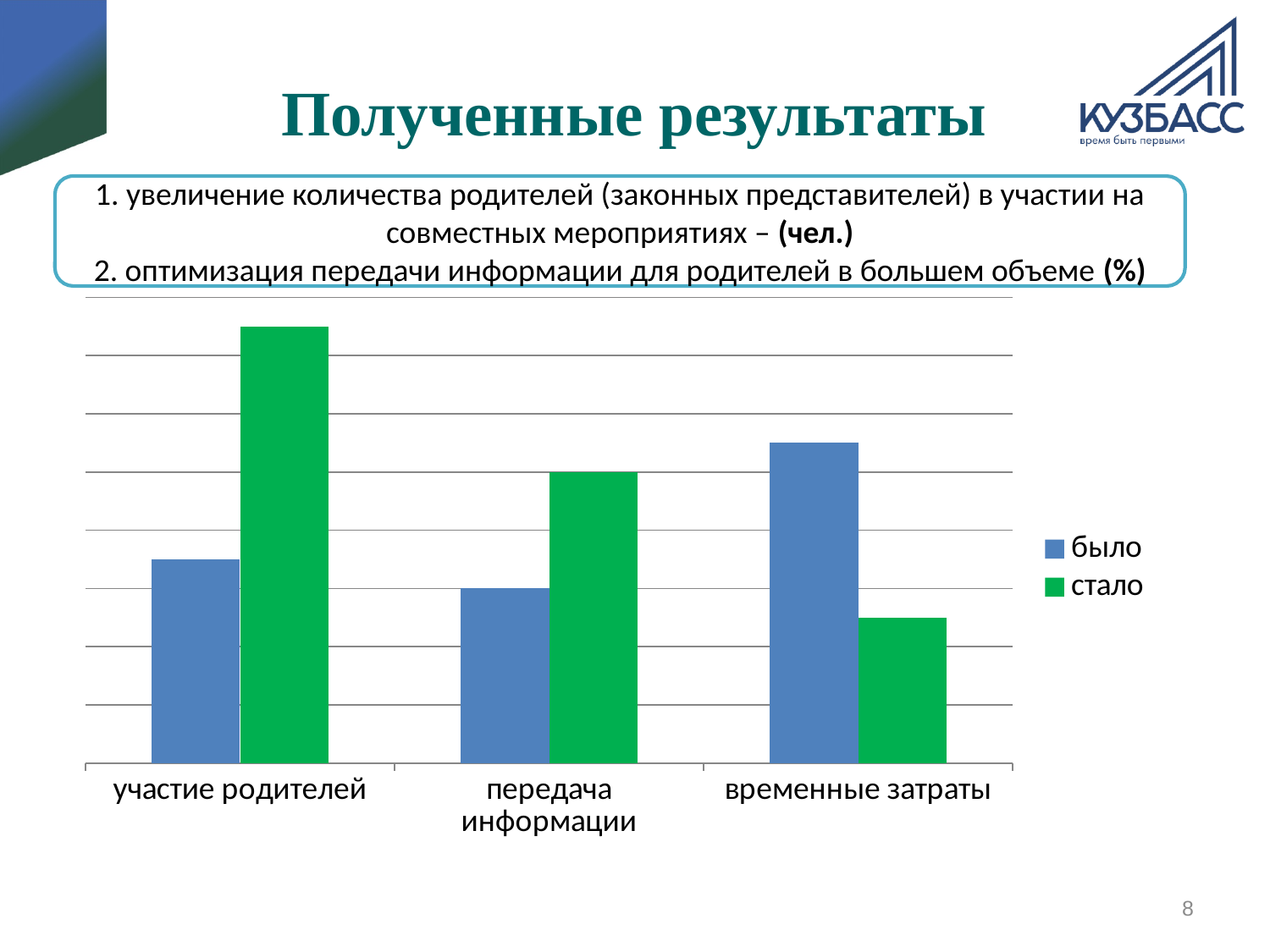
How many categories are shown on the x axis of the chart? 3 For the category 'временные затраты', which is larger: 'было' or 'стало'? было In which category is the 'было' bar the highest? временные затраты What are the two series named in the chart's legend? было, стало In which category is the 'стало' bar the highest? участие родителей Do the 'стало' bars rise or fall from left to right along the x axis? fall In which category is the 'стало' bar the lowest? временные затраты How many series does the chart's legend list? 2 Which colour represents the series 'стало' in the chart? green What kind of chart is shown on the slide? bar chart For the category 'участие родителей', which is larger: 'было' or 'стало'? стало For the category 'передача информации', which is larger: 'было' or 'стало'? стало